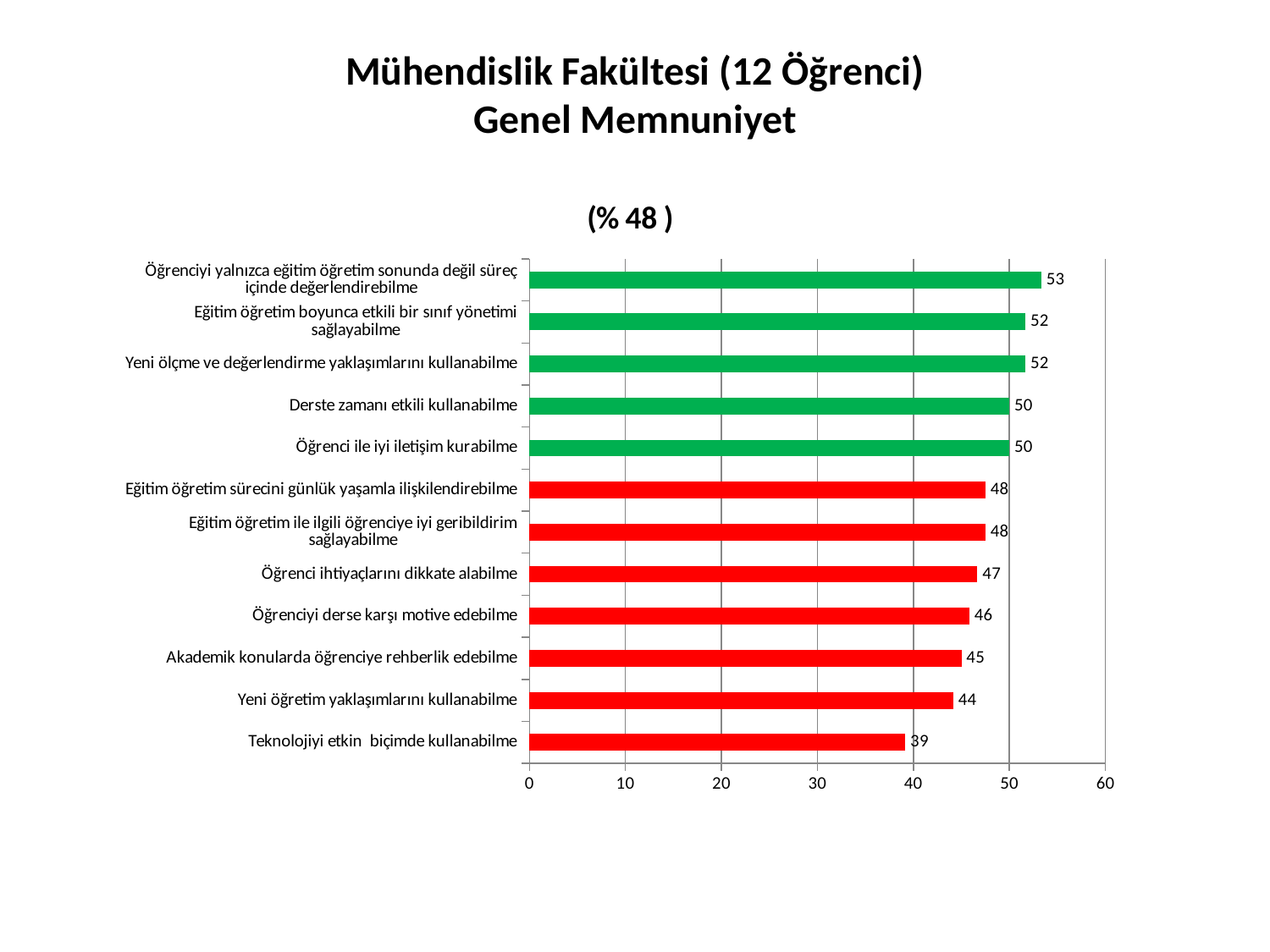
What is the chart's title? (% 48 ) Which category has the highest value? Öğrenciyi yalnızca eğitim öğretim sonunda değil süreç içinde değerlendirebilme Which category has the lowest value? Teknolojiyi etkin biçimde kullanabilme What is the difference between "Akademik konularda öğrenciye rehberlik edebilme" and "Yeni öğretim yaklaşımlarını kullanabilme"? 1 What is the difference between the highest value (53) and the lowest value (39)? 14 What is the value for "Öğrenciyi derse karşı motive edebilme"? 46 How many categories are shown in the chart? 12 What is the value for "Teknolojiyi etkin biçimde kullanabilme"? 39 What is the value for "Derste zamanı etkili kullanabilme"? 50 Is the value for "Yeni ölçme ve değerlendirme yaklaşımlarını kullanabilme" greater or less than 50? greater Which is larger: "Öğrenci ihtiyaçlarını dikkate alabilme" or "Yeni öğretim yaklaşımlarını kullanabilme"? Öğrenci ihtiyaçlarını dikkate alabilme What kind of chart is shown on the slide? bar chart